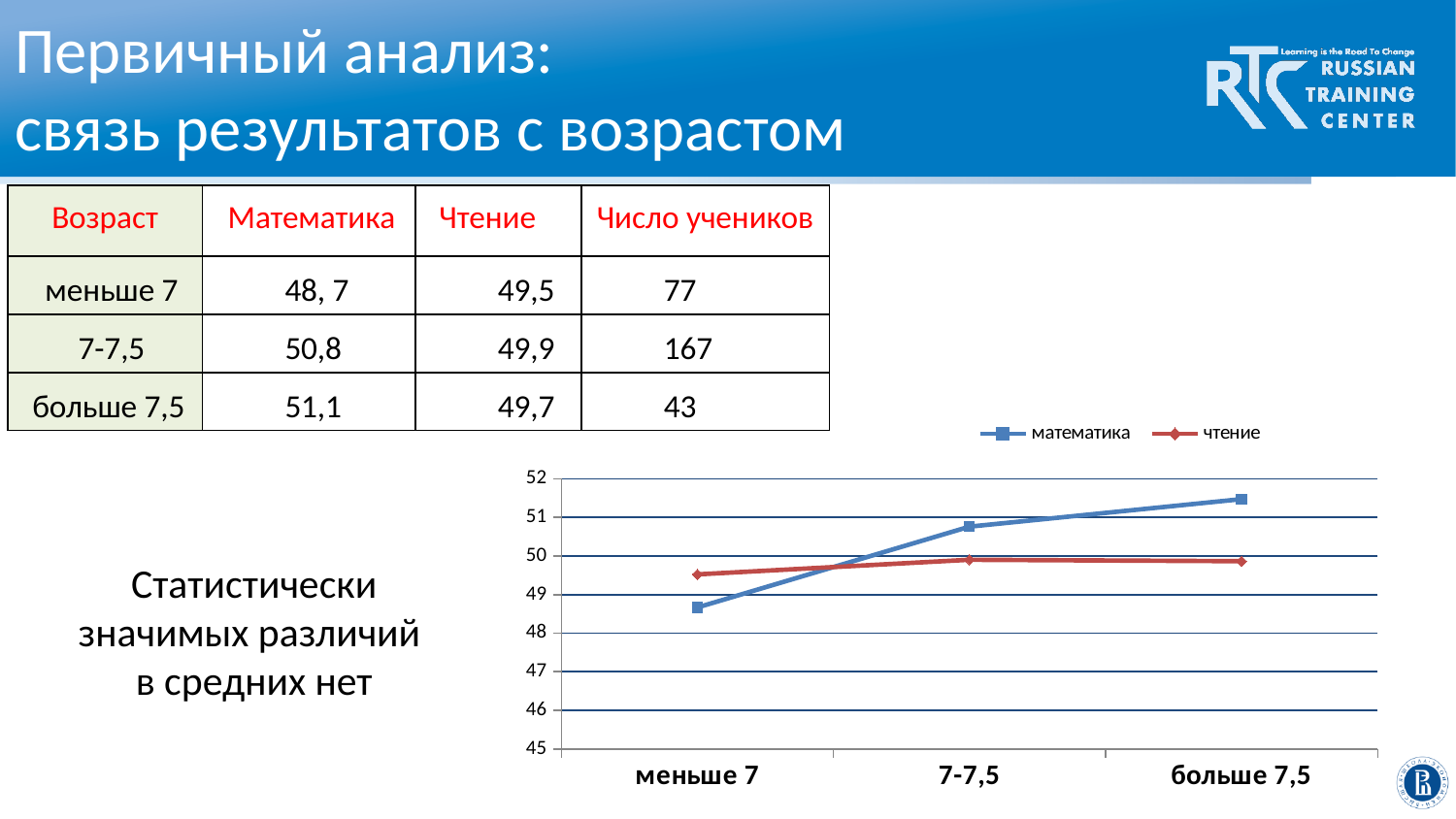
Does the математика line rise or fall from 'меньше 7' to 'больше 7,5'? rises For which age category is the математика value lowest? меньше 7 How many age categories are plotted along the x axis of the chart? 3 At 'меньше 7', which series has the larger value, математика or чтение? чтение At 'больше 7,5', which series has the larger value, математика or чтение? математика How many series does the chart legend list? 2 Which series does the blue line with square markers represent? математика For which age category is the математика value highest? больше 7,5 Is the математика value for 'меньше 7' greater or less than 49? less What kind of chart is shown on the slide? line chart Is the математика value for 'больше 7,5' greater or less than 51? greater